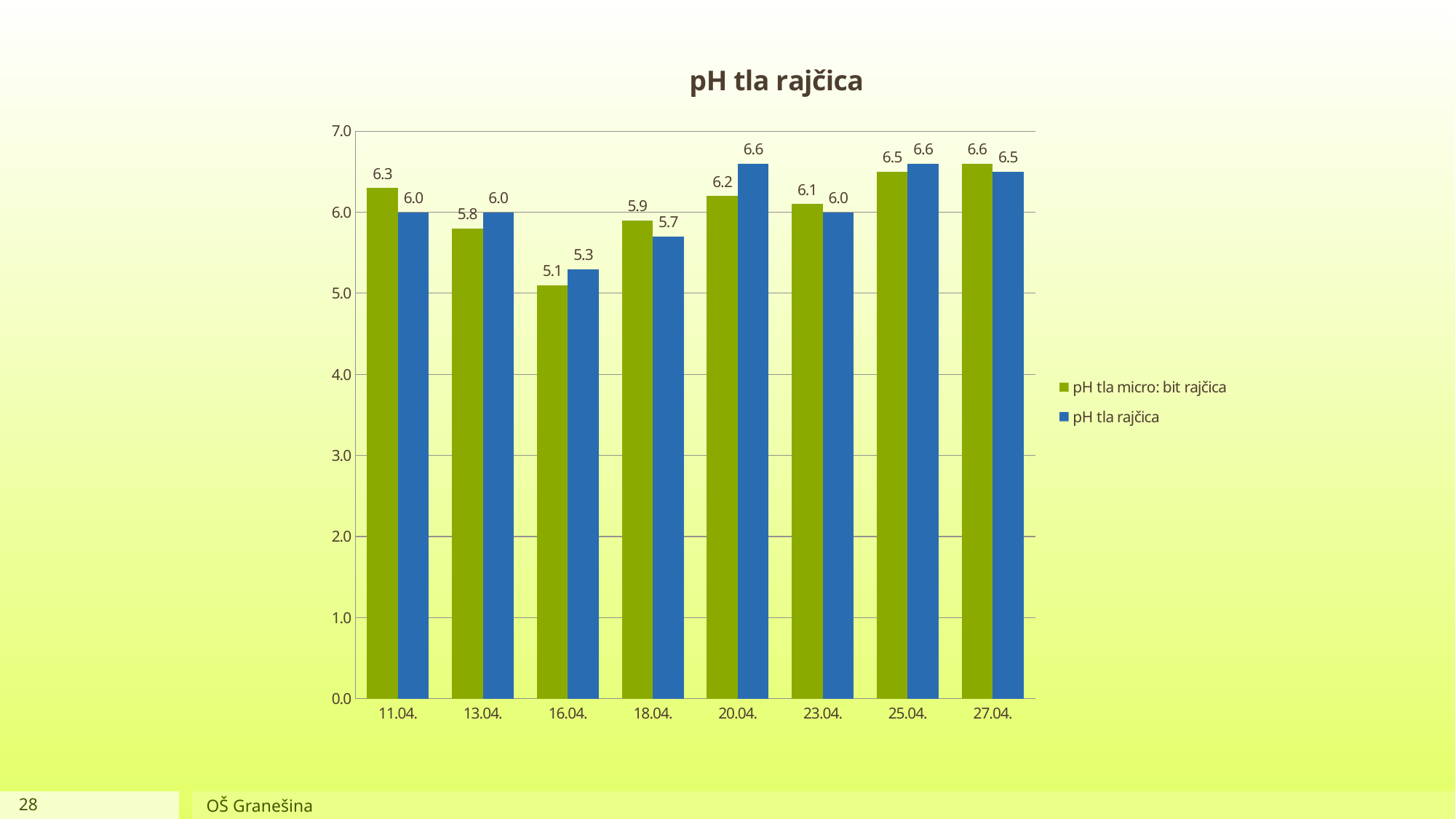
On which date is pH tla micro: bit rajčica highest? 27.04. How many series does the legend list? 2 What is the value of pH tla micro: bit rajčica on 16.04.? 5.1 On which date is pH tla rajčica lowest? 16.04. What is the title of the chart? pH tla rajčica What is the value of pH tla rajčica on 20.04.? 6.6 What kind of chart is shown on the slide? bar chart On 11.04., which series has the larger value, pH tla micro: bit rajčica or pH tla rajčica? pH tla micro: bit rajčica On which date is pH tla micro: bit rajčica lowest? 16.04. What is the value of pH tla micro: bit rajčica on 27.04.? 6.6 How many dates are shown on the x axis? 8 What is the difference between pH tla rajčica and pH tla micro: bit rajčica on 20.04.? 0.4